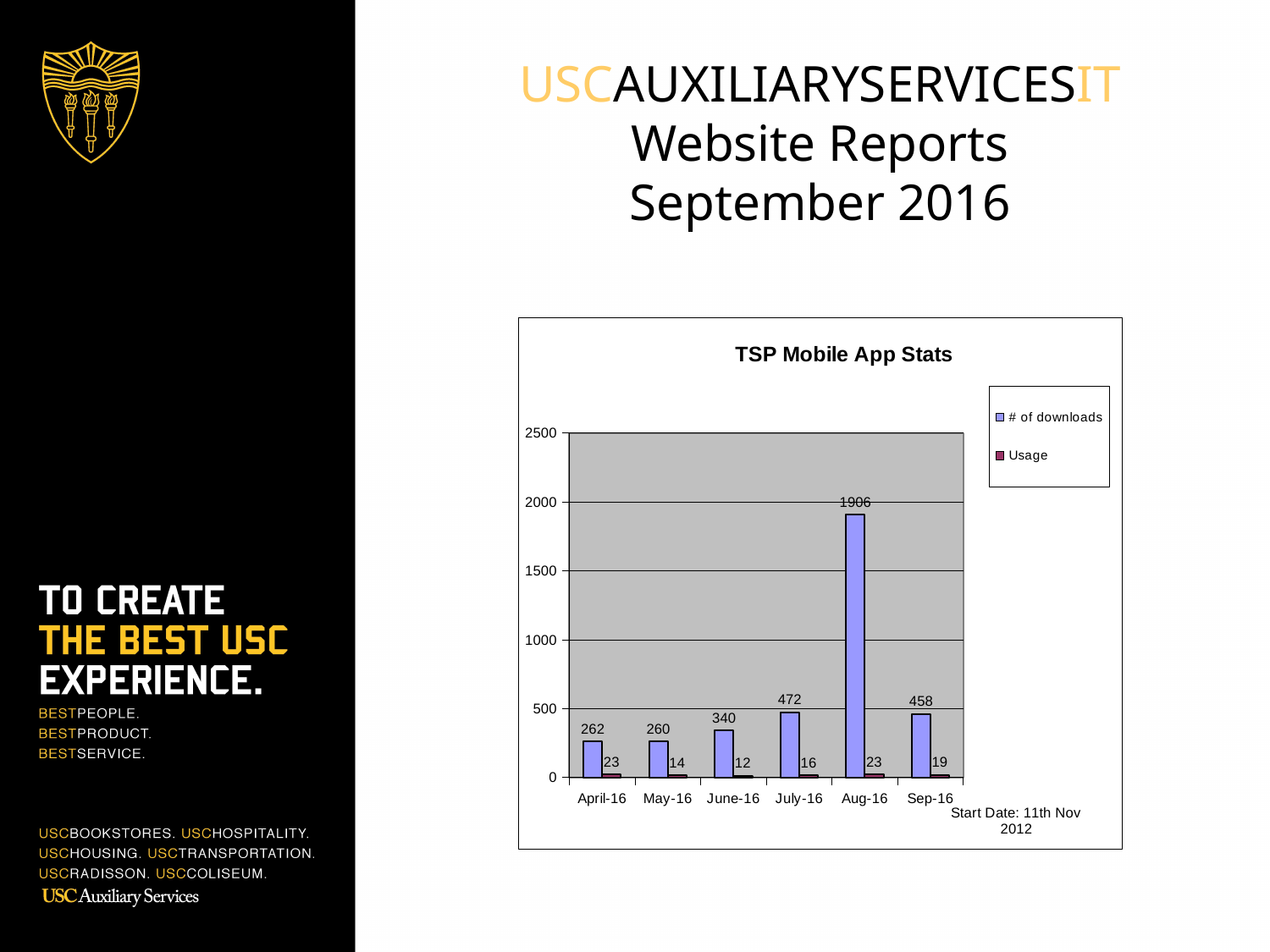
What is the Usage value for June-16? 12 What is the number of downloads for Aug-16? 1906 Which month has the lowest Usage value? June-16 Which month has the highest number of downloads? Aug-16 Is the number of downloads for Aug-16 greater or less than 1500? greater How many series does the legend list? 2 Which is larger, the number of downloads for April-16 or May-16? April-16 What is the difference in number of downloads between Aug-16 and Sep-16? 1448 What is the number of downloads for July-16? 472 What is the title of the chart? TSP Mobile App Stats How many months are shown on the x axis? 6 What kind of chart is shown? bar chart